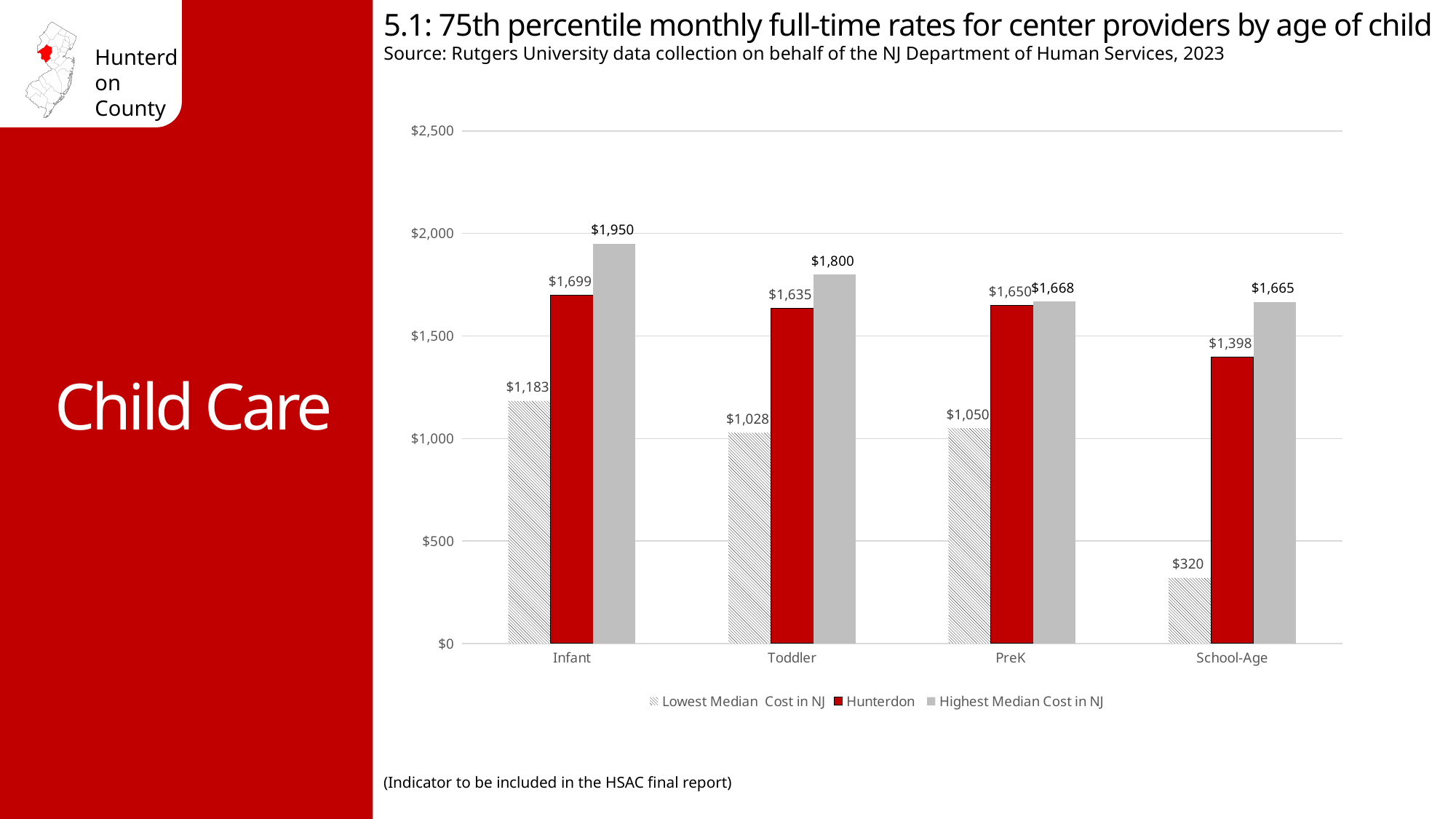
What is the Lowest Median Cost in NJ for School-Age? $320 How many age groups are shown on the x axis? 4 What is the Hunterdon value for Infant? $1,699 How many series does the legend list? 3 Which age group has the highest Hunterdon value? Infant Which is larger for Toddler: the Hunterdon value or the Lowest Median Cost in NJ? Hunterdon Which series is shown in red? Hunterdon What kind of chart is shown? Bar chart What is the Hunterdon value for PreK? $1,650 What is the Highest Median Cost in NJ for Toddler? $1,800 Which age group has the lowest Lowest Median Cost in NJ value? School-Age What is the difference between the Highest Median Cost in NJ and the Hunterdon value for Infant? $251